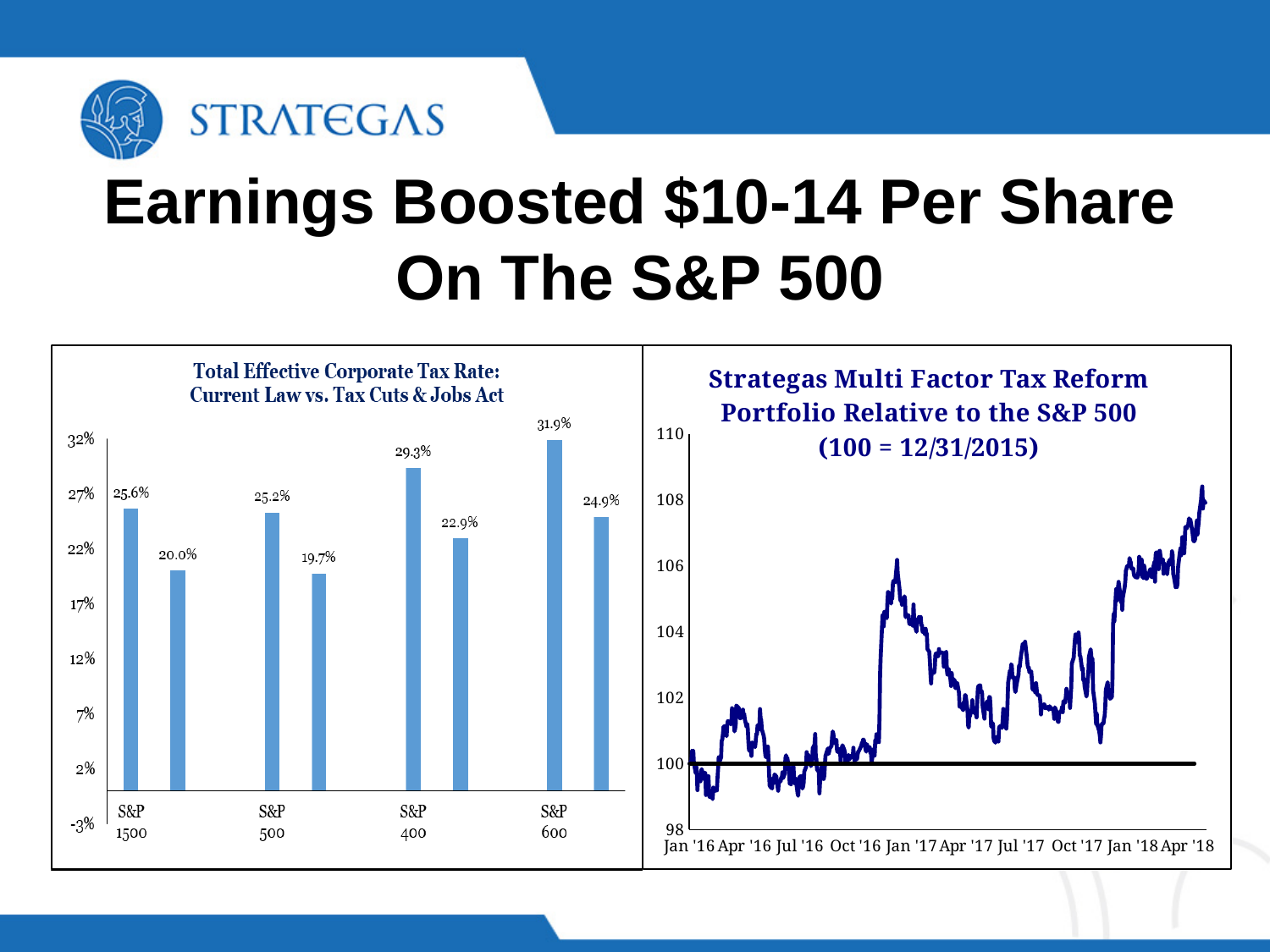
In the left chart, which is larger: the taller bar for S&P 1500 or the taller bar for S&P 500? S&P 1500 (25.6%) What kind of chart is the left chart, 'Total Effective Corporate Tax Rate: Current Law vs. Tax Cuts & Jobs Act'? Bar chart In the left chart, what is the value of the shorter bar for S&P 600? 24.9% In the left chart, what is the difference between the two bars for S&P 400 (29.3% and 22.9%)? 6.4 percentage points In the left chart, what is the value of the taller bar for S&P 1500? 25.6% In the right chart, does the line overall rise or fall from Jan '16 to Apr '18? Rise In the left chart, what is the lowest value labeled on any bar? 19.7% In the right chart, what date is the index base of 100 set to, according to the title? 12/31/2015 In the left chart, what is the highest value labeled on any bar? 31.9% In the right chart, is the value at Apr '18 greater or less than 106? greater What kind of chart is the right chart, 'Strategas Multi Factor Tax Reform Portfolio Relative to the S&P 500'? Line chart In the left chart, how many index groups are shown on the x axis? 4